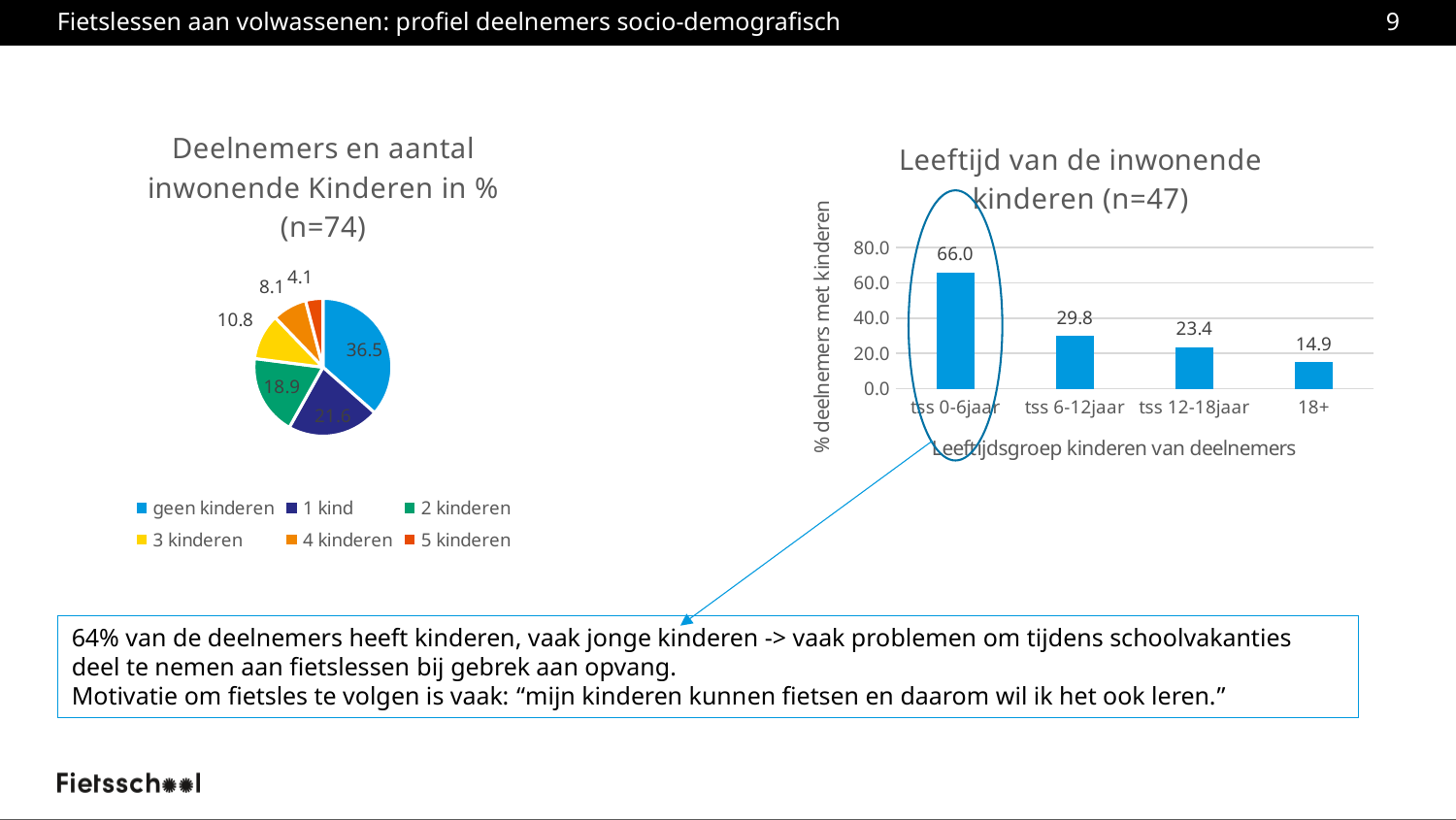
What kind of chart is 'Leeftijd van de inwonende kinderen (n=47)'? bar chart In the bar chart 'Leeftijd van de inwonende kinderen (n=47)', what is the difference between the values for 'tss 6-12jaar' and 'tss 12-18jaar'? 6.4 In the bar chart 'Leeftijd van de inwonende kinderen (n=47)', which age group has the lowest value? 18+ In the pie chart 'Deelnemers en aantal inwonende Kinderen in % (n=74)', which category has the smallest slice? 5 kinderen In the bar chart 'Leeftijd van de inwonende kinderen (n=47)', how many age groups are shown on the x axis? 4 In the bar chart 'Leeftijd van de inwonende kinderen (n=47)', what is the value for 'tss 0-6jaar'? 66.0 In the bar chart 'Leeftijd van de inwonende kinderen (n=47)', which age group has the highest value? tss 0-6jaar How many categories does the legend of the pie chart 'Deelnemers en aantal inwonende Kinderen in % (n=74)' list? 6 In the bar chart 'Leeftijd van de inwonende kinderen (n=47)', do the values rise or fall from left to right along the x axis? fall In the pie chart 'Deelnemers en aantal inwonende Kinderen in % (n=74)', what is the value for 'geen kinderen'? 36.5 In the pie chart 'Deelnemers en aantal inwonende Kinderen in % (n=74)', which is larger: '1 kind' or '2 kinderen'? 1 kind In the bar chart 'Leeftijd van de inwonende kinderen (n=47)', what is the value for '18+'? 14.9